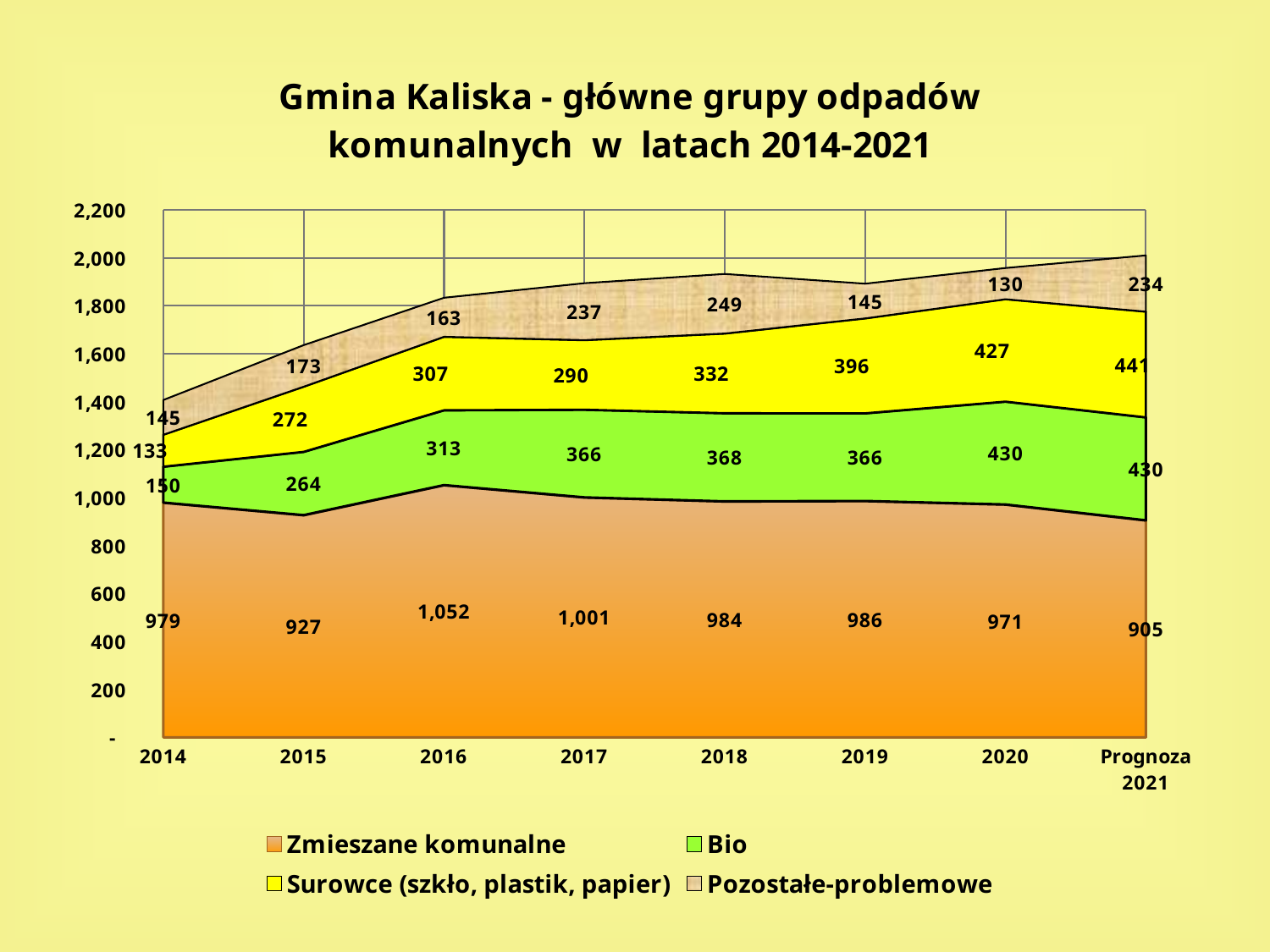
What is the value for Zmieszane komunalne in 2016? 1,052 What is the value for Bio in 2020? 430 What is the total of all four series in 2020? 1,958 How many categories are shown on the x axis? 8 In which year is the value for Pozostałe-problemowe the lowest? 2020 In which year is the value for Zmieszane komunalne the highest? 2016 What is the value for Surowce (szkło, plastik, papier) in Prognoza 2021? 441 What is the difference between the Surowce (szkło, plastik, papier) value in 2020 and in 2014? 294 How many series does the legend list? 4 In 2015, which is larger: the value for Bio or the value for Surowce (szkło, plastik, papier)? Surowce (szkło, plastik, papier) What kind of chart is shown on the slide? Stacked area chart What is the value for Pozostałe-problemowe in 2018? 249